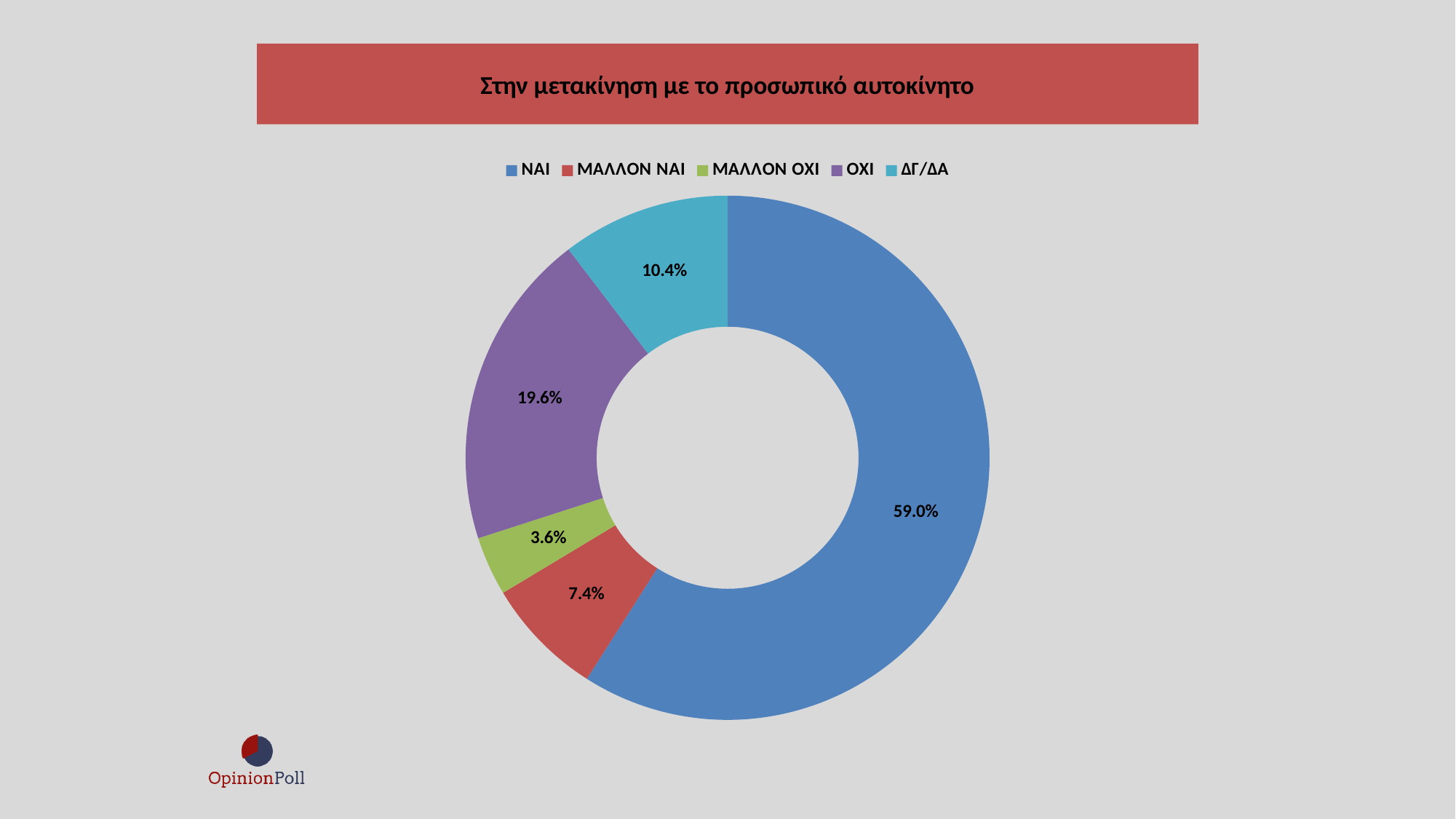
What percentage is shown for ΝΑΙ? 59.0% What kind of chart is shown on the slide? Pie chart (doughnut) What is the title of the chart? Στην μετακίνηση με το προσωπικό αυτοκίνητο What is the difference in percentage points between ΝΑΙ and ΟΧΙ? 39.4 Which category has the smallest share? ΜΑΛΛΟΝ ΟΧΙ What percentage is shown for ΜΑΛΛΟΝ ΟΧΙ? 3.6% Which category has the largest share? ΝΑΙ How many categories does the chart show? 5 Which is larger, ΟΧΙ or ΔΓ/ΔΑ? ΟΧΙ What percentage is shown for ΔΓ/ΔΑ? 10.4% What percentage is shown for ΜΑΛΛΟΝ ΝΑΙ? 7.4% What percentage is shown for ΟΧΙ? 19.6%